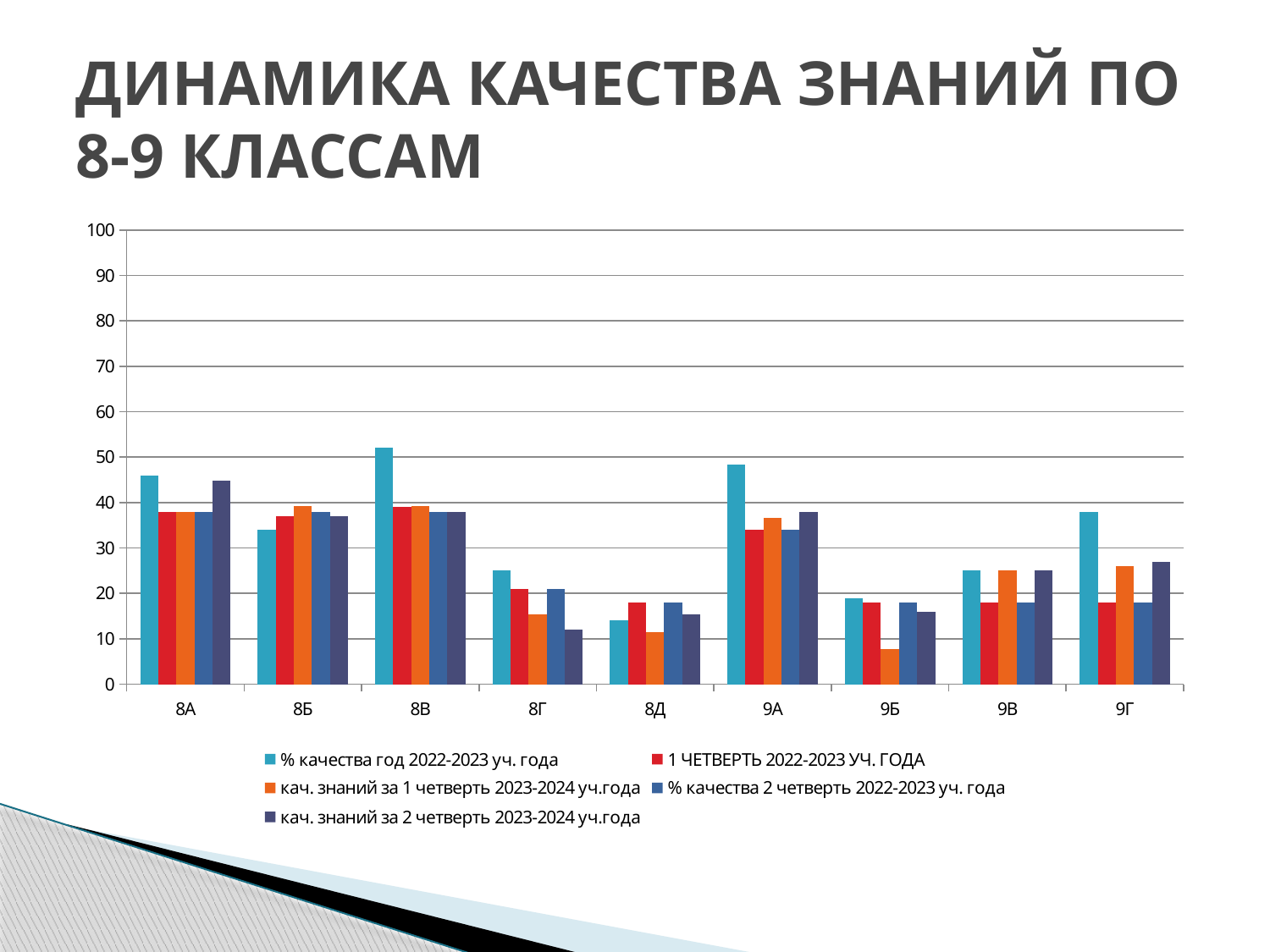
What kind of chart is shown on the slide? bar chart Is the value for 9А in the series '% качества год 2022-2023 уч. года' greater or less than 40? greater How many series does the chart's legend list? 5 How many classes (categories) are shown on the x axis of the chart? 9 Which class has the lowest value for 'кач. знаний за 1 четверть 2023-2024 уч.года'? 9Б Is the value for 9Б in the series 'кач. знаний за 1 четверть 2023-2024 уч.года' greater or less than 10? less What is the title of the slide containing the chart? ДИНАМИКА КАЧЕСТВА ЗНАНИЙ ПО 8-9 КЛАССАМ Which class has the lowest value for '% качества год 2022-2023 уч. года'? 8Д For the series '% качества год 2022-2023 уч. года', which class has the larger value, 9В or 9Г? 9Г Is the value for 8В in the series '% качества год 2022-2023 уч. года' greater or less than 50? greater Which class has the highest value for '% качества год 2022-2023 уч. года'? 8В For the series '% качества год 2022-2023 уч. года', which class has the larger value, 8Г or 8Д? 8Г